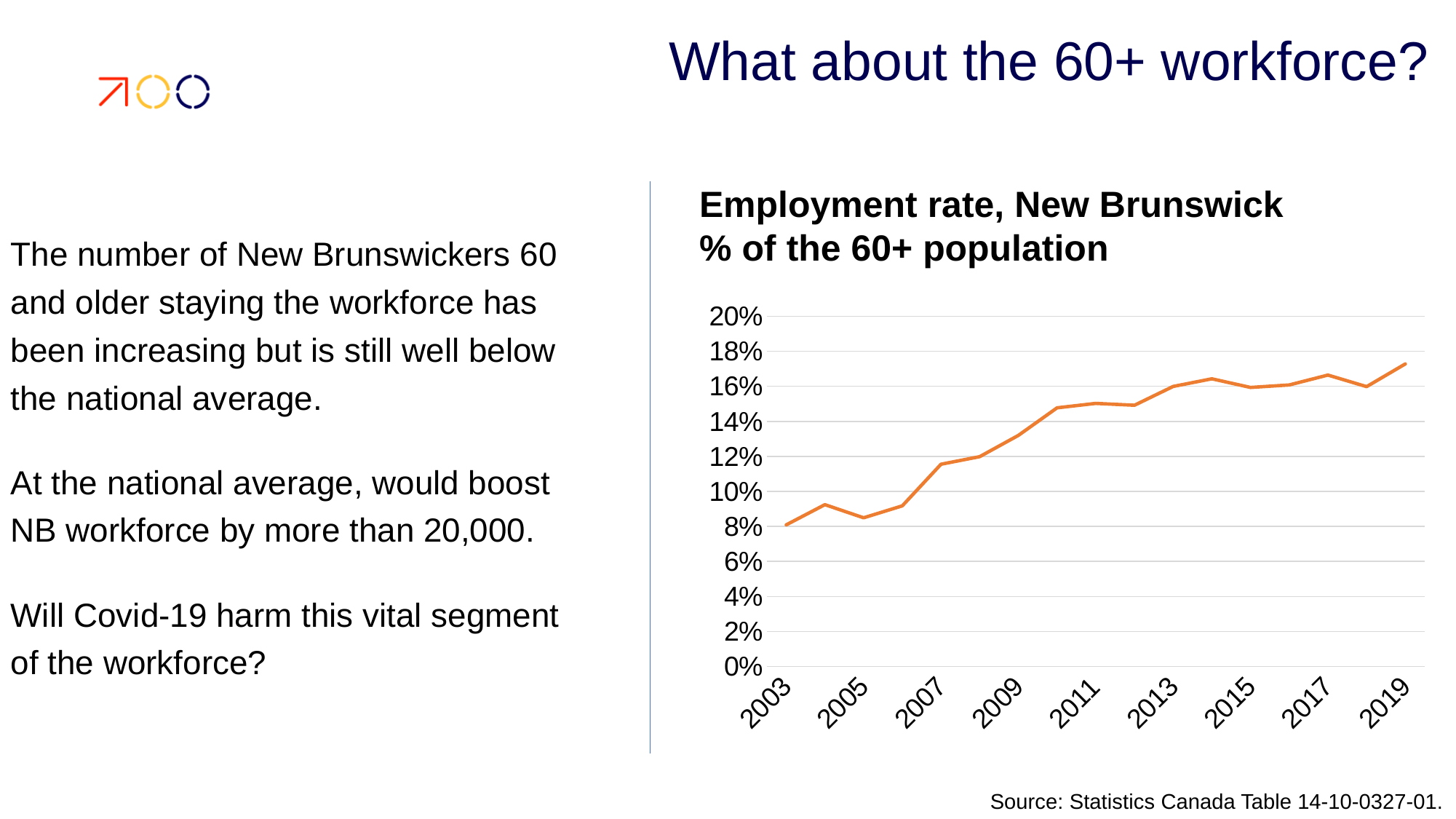
What is the highest value shown on the chart's y axis? 20% Does the employment rate of the 60+ population in New Brunswick generally rise or fall from 2003 to 2019? rise Is the employment rate for 2011 greater or less than 14%? greater Which year has the highest employment rate in the chart? 2019 How many year labels appear on the x axis of the chart? 9 What is the title of the chart? Employment rate, New Brunswick % of the 60+ population Is the employment rate in 2019 higher or lower than in 2003? higher Is the employment rate for 2009 greater or less than 14%? less What kind of chart is shown on the slide? line chart Is the employment rate for 2019 greater or less than 16%? greater